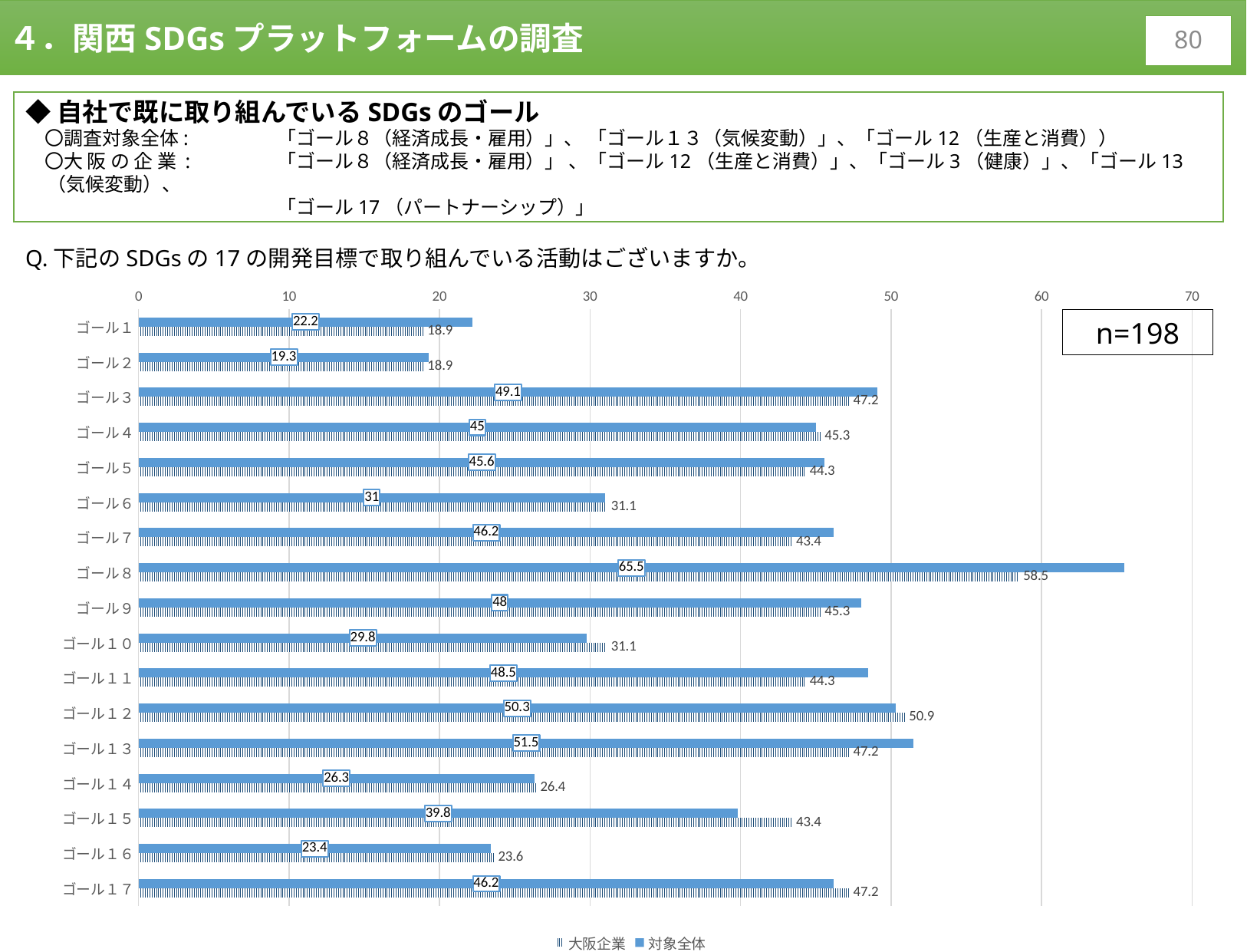
For ゴール１５, which is larger: 大阪企業 or 対象全体? 大阪企業 Which goal has the highest value for 対象全体? ゴール８ What is the value for 大阪企業 for ゴール１２? 50.9 What sample size (n) is shown on the chart? n=198 Which goal has the lowest value for 対象全体? ゴール２ What kind of chart is shown on the slide? bar chart What is the value for 対象全体 for ゴール８? 65.5 What is the value for 大阪企業 for ゴール１３? 47.2 What is the difference between the 対象全体 and 大阪企業 values for ゴール８? 7 How many goals (categories) are shown on the chart? 17 How many series does the legend list? 2 What is the value for 対象全体 for ゴール１５? 39.8